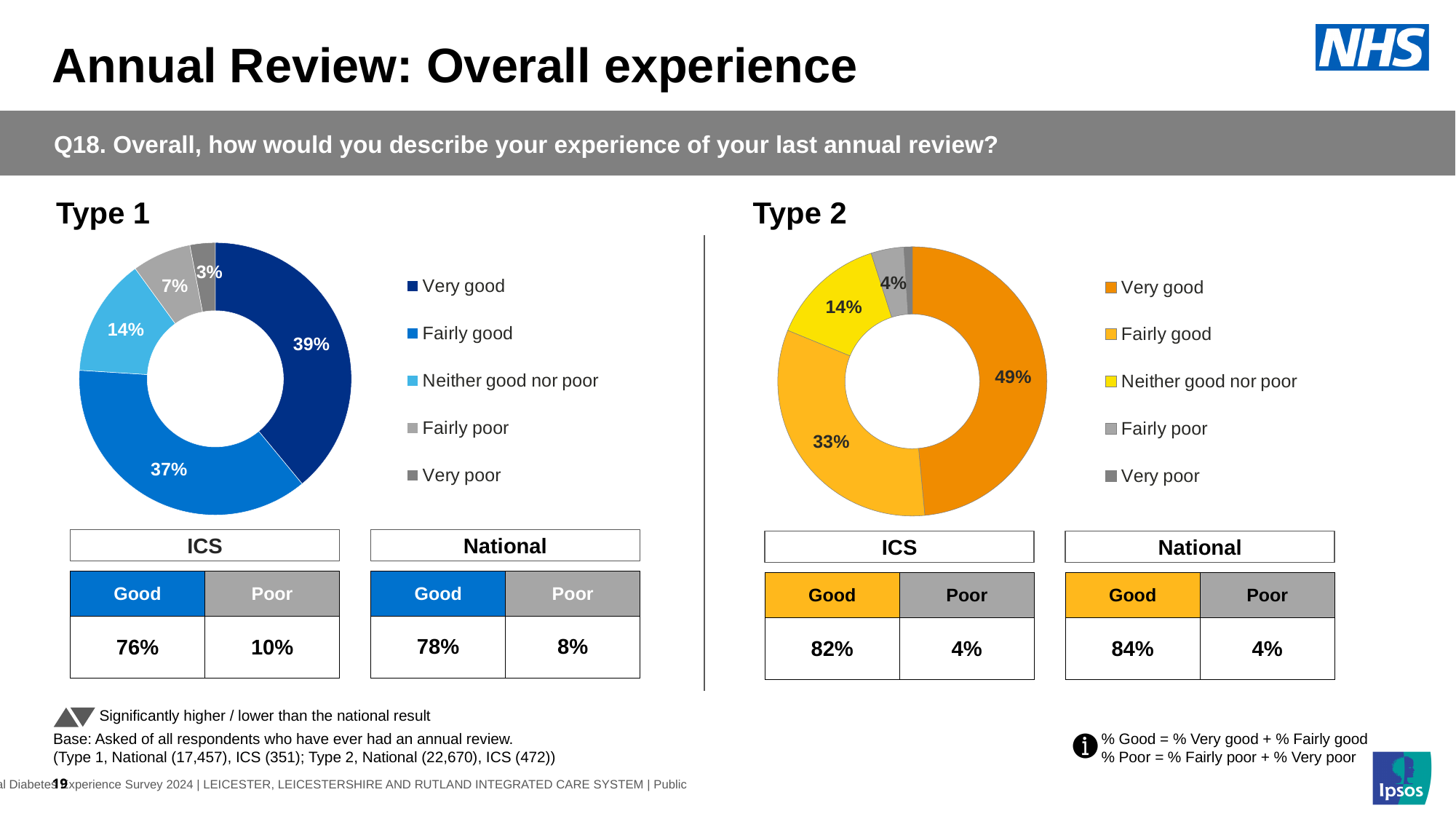
How many response categories does the legend of the Type 2 chart list? 5 In the Type 1 chart, what percentage of respondents said their experience was Very good? 39% In the Type 1 chart, what percentage of respondents said Fairly good? 37% In the Type 2 chart, which response category has the largest share? Very good Which is larger: the Very good share in the Type 1 chart or the Very good share in the Type 2 chart? Type 2 In the Type 1 chart, what is the difference between the Neither good nor poor and Fairly poor shares? 7 percentage points In the Type 2 chart, what percentage of respondents said Neither good nor poor? 14% In the Type 1 chart, which response category has the smallest share? Very poor What type of chart is used for Type 1? Doughnut (pie) chart In the Type 2 chart, what is the difference between the Very good and Fairly good shares? 16 percentage points In the Type 1 chart, which response category has the largest share? Very good In the Type 2 chart, what percentage of respondents said Very good? 49%